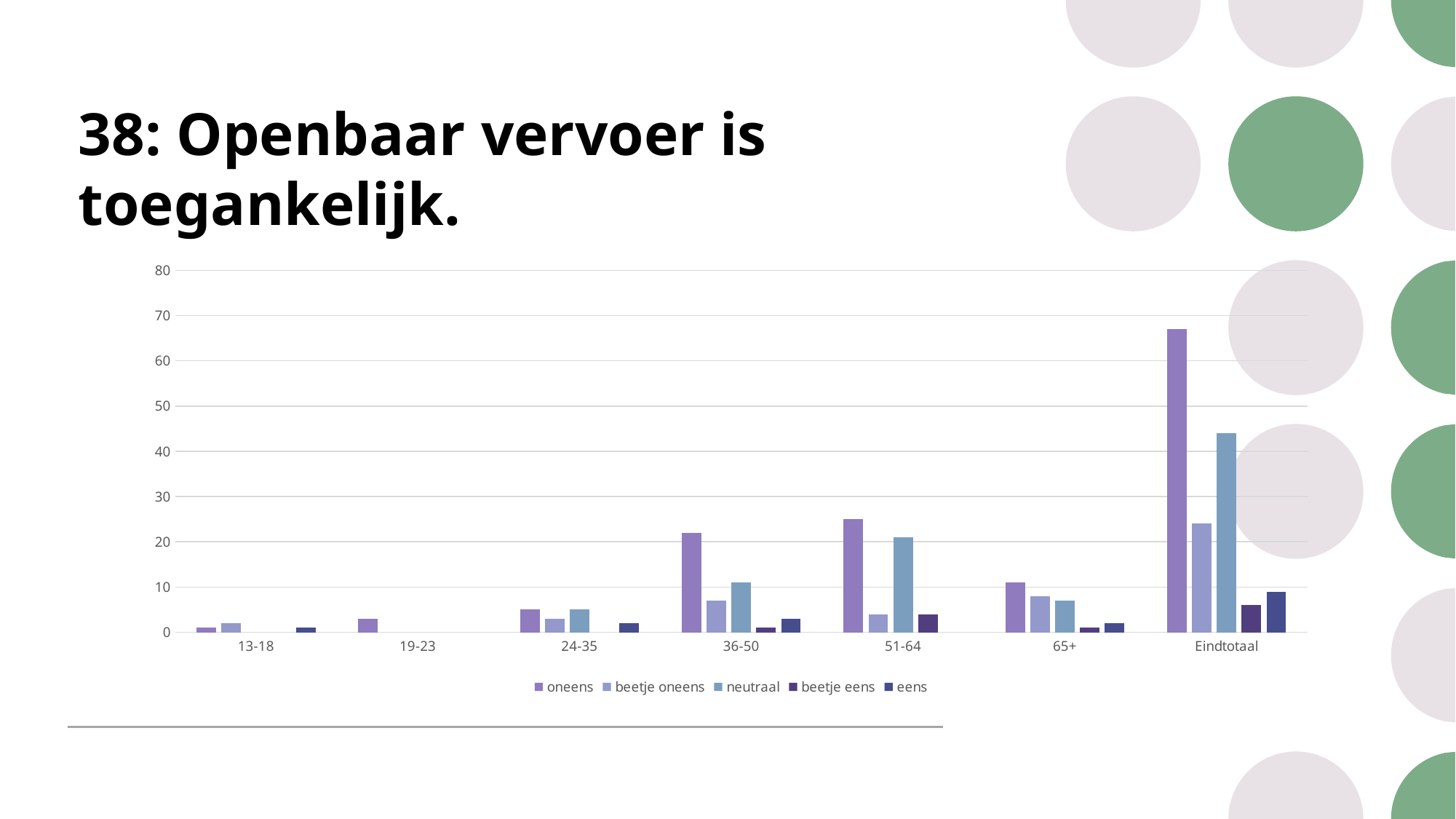
In the Eindtotaal category, which series has the lowest bar? beetje eens Which is larger: the 'oneens' value for 36-50 or the 'oneens' value for 51-64? 51-64 What kind of chart is shown on the slide? bar chart Is the value for 'beetje oneens' in the Eindtotaal category greater or less than 30? less What is the title of the slide? 38: Openbaar vervoer is toegankelijk. How many categories are shown on the x axis? 7 Which category has the highest 'oneens' bar? Eindtotaal How many series does the legend list? 5 Is the value for 'oneens' in the Eindtotaal category greater or less than 60? greater Is the value for 'neutraal' in the Eindtotaal category greater or less than 40? greater